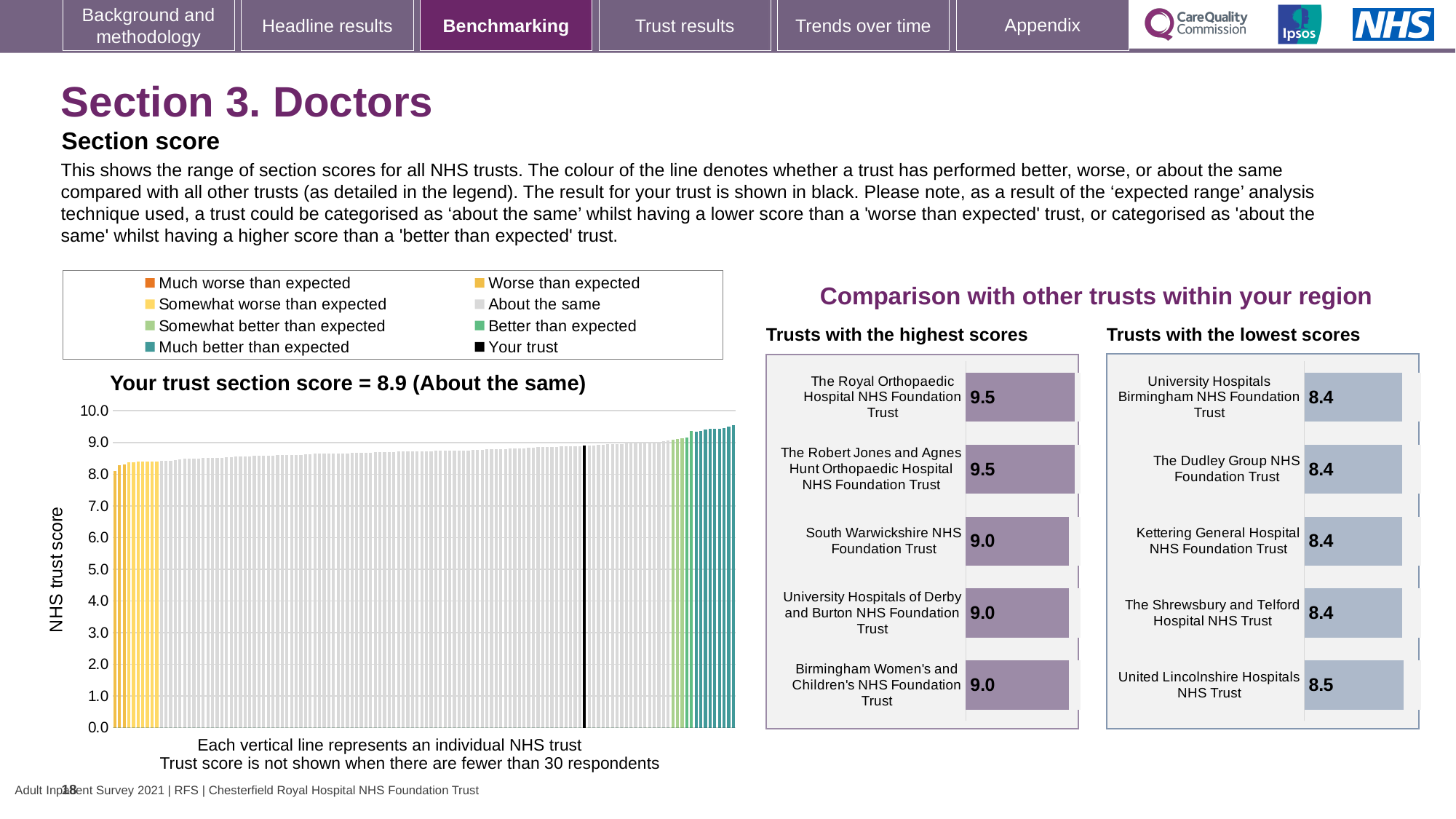
What is the y-axis label of the main chart showing the range of section scores? NHS trust score In the 'Trusts with the highest scores' chart, what is the score for South Warwickshire NHS Foundation Trust? 9.0 In the main chart titled 'Your trust section score', what is the section score for your trust? 8.9 How many entries does the legend above the main section score chart list? 8 In the 'Trusts with the lowest scores' chart, what is the score for Kettering General Hospital NHS Foundation Trust? 8.4 In the 'Trusts with the highest scores' chart, what is the score for The Royal Orthopaedic Hospital NHS Foundation Trust? 9.5 In the main chart titled 'Your trust section score', what category is your trust placed in? About the same In the 'Trusts with the highest scores' chart, what is the difference between the scores of The Royal Orthopaedic Hospital NHS Foundation Trust and Birmingham Women's and Children's NHS Foundation Trust? 0.5 In the 'Trusts with the lowest scores' chart, which trust has the highest score? United Lincolnshire Hospitals NHS Trust In the main chart showing the range of section scores, do the trust scores rise or fall from left to right along the x axis? rise In the 'Trusts with the highest scores' chart, how many trusts are shown? 5 What kind of chart is the main chart showing the range of section scores for all NHS trusts? bar chart